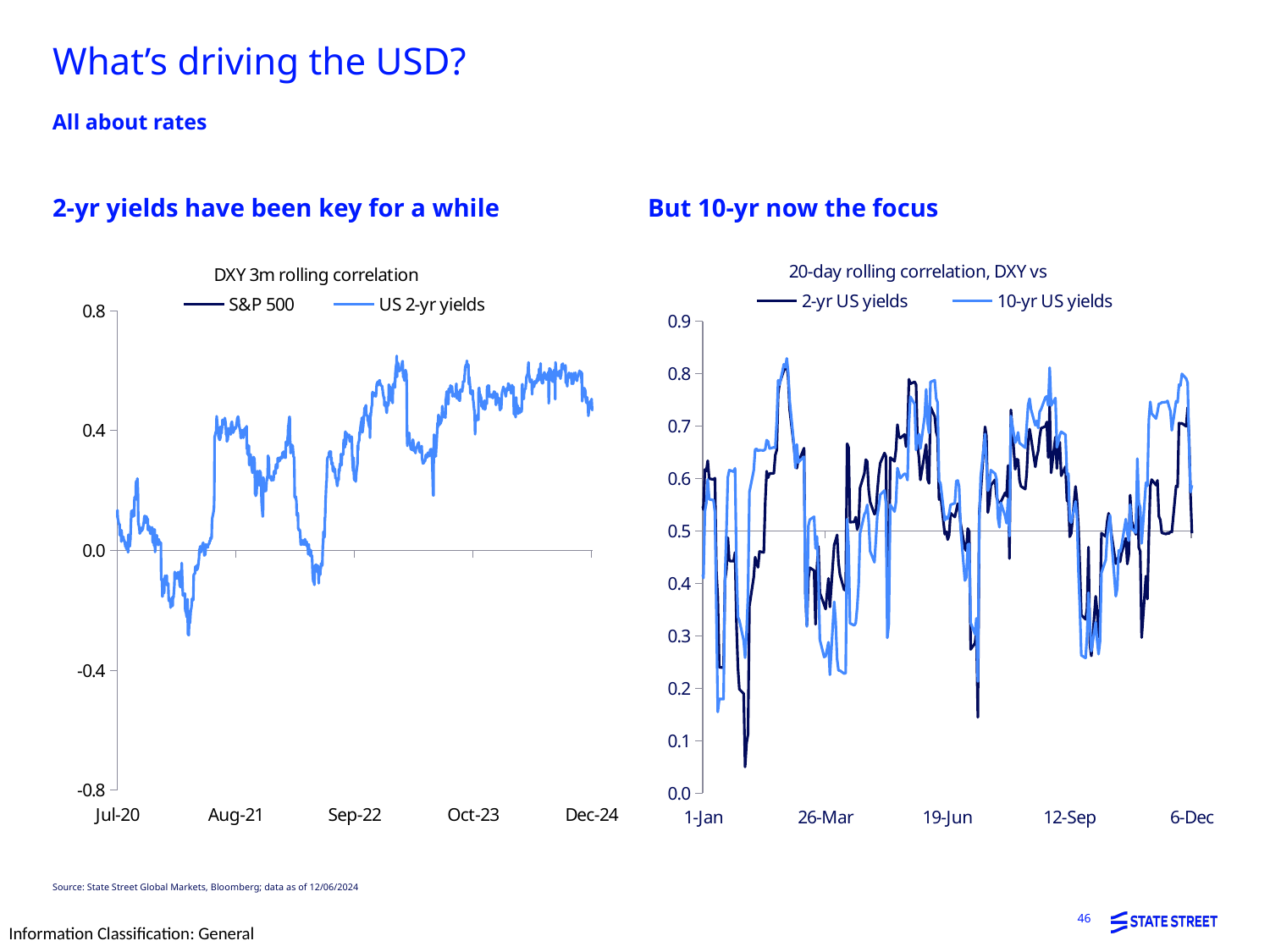
In the left chart 'DXY 3m rolling correlation', is the lowest point of the US 2-yr yields line greater or less than 0.0? less In the right chart '20-day rolling correlation, DXY vs', is the highest point of the 10-yr US yields line greater or less than 0.8? greater In the left chart 'DXY 3m rolling correlation', does the US 2-yr yields correlation overall rise or fall from Jul-20 to Dec-24? rise What type of chart is the right chart titled '20-day rolling correlation, DXY vs'? line chart How many series does the legend of the right chart '20-day rolling correlation, DXY vs' list? 2 In the right chart '20-day rolling correlation, DXY vs', which series is drawn in dark navy? 2-yr US yields In the right chart '20-day rolling correlation, DXY vs', is the lowest point of the 2-yr US yields line greater or less than 0.1? less What type of chart is the left chart titled 'DXY 3m rolling correlation'? line chart How many series does the legend of the left chart 'DXY 3m rolling correlation' list? 2 In the left chart 'DXY 3m rolling correlation', which series is drawn in light blue? US 2-yr yields How many date labels are shown on the x axis of the right chart '20-day rolling correlation, DXY vs'? 5